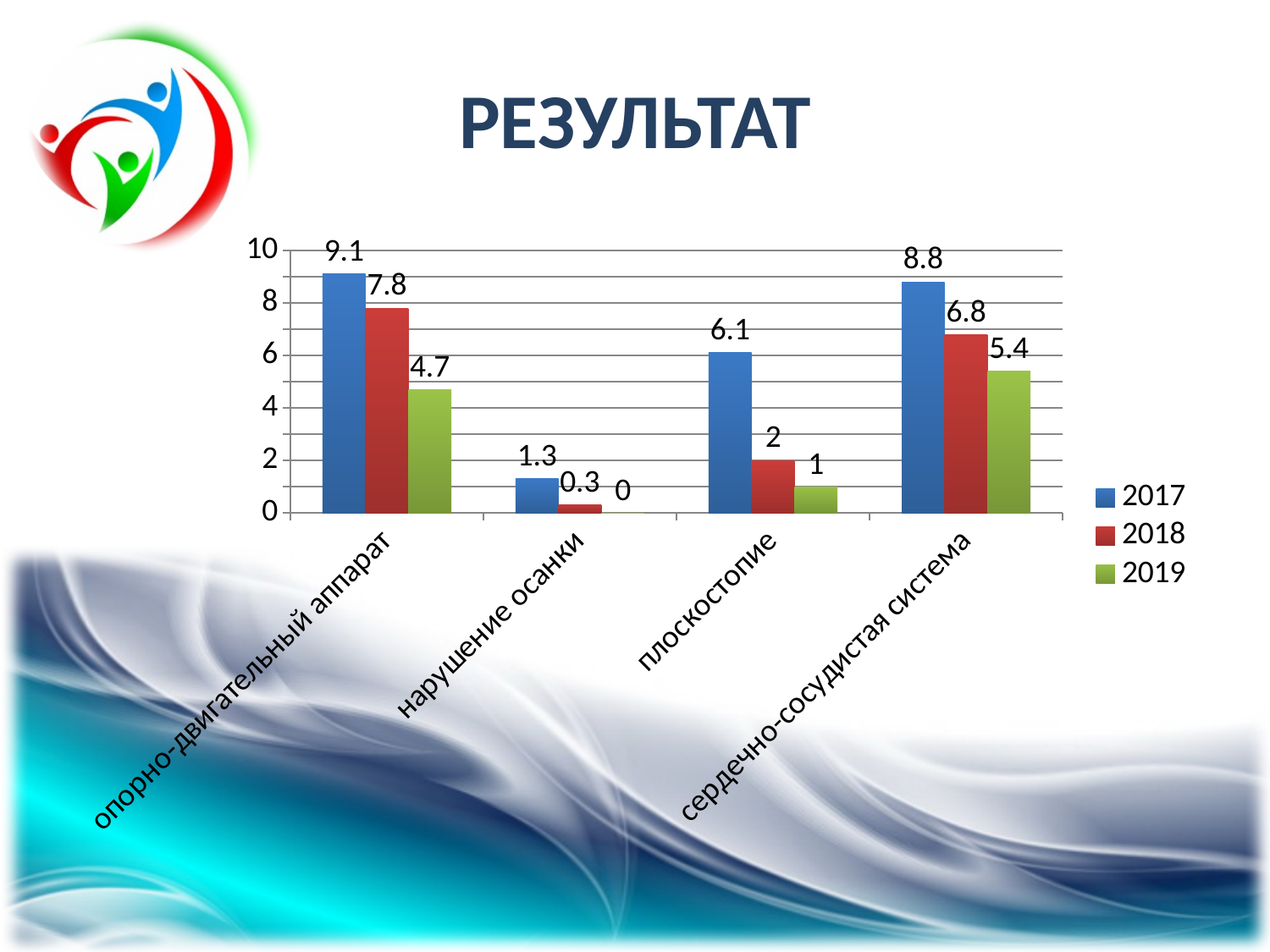
What is the value for 2019 in the нарушение осанки category? 0 What is the value for 2019 in the сердечно-сосудистая система category? 5.4 What is the value for 2018 in the плоскостопие category? 2 How many categories are shown on the x axis? 4 Do the values for плоскостопие rise or fall from 2017 to 2019? fall How many series does the legend list? 3 Which is larger: the 2017 value for опорно-двигательный аппарат or the 2017 value for сердечно-сосудистая система? опорно-двигательный аппарат What is the difference between the 2017 and 2019 values for сердечно-сосудистая система? 3.4 What is the value for 2017 in the опорно-двигательный аппарат category? 9.1 Which category has the highest value for 2018? опорно-двигательный аппарат Which category has the lowest value for 2017? нарушение осанки What kind of chart is shown on the slide? bar chart